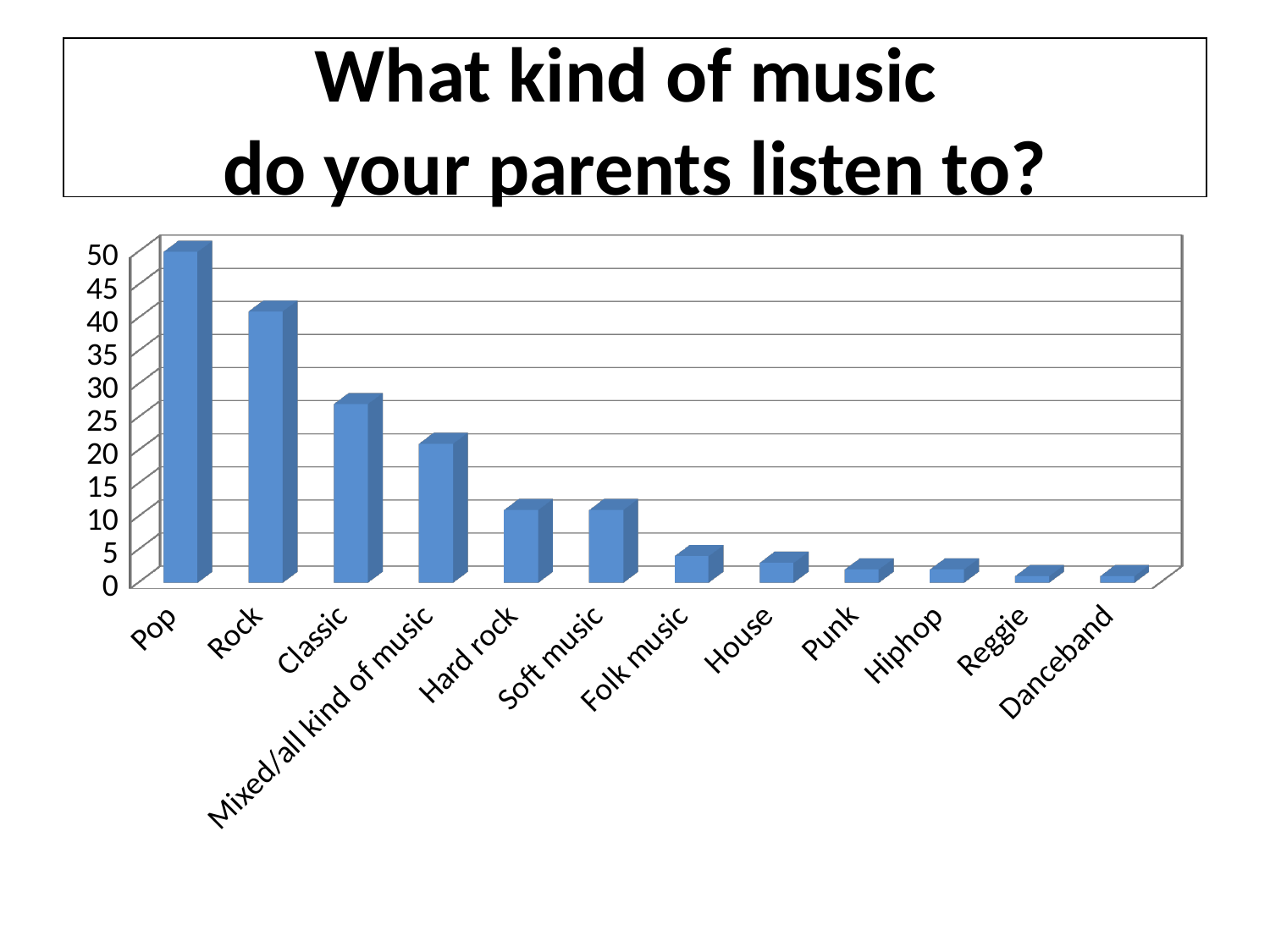
Is the value for Pop greater or less than 45? greater Do the values generally rise or fall moving from left to right along the x axis? fall Which is larger, the value for Mixed/all kind of music or the value for Folk music? Mixed/all kind of music Which is larger, the value for Classic or the value for Hard rock? Classic How many music categories are shown on the x axis? 12 Is the value for Rock greater or less than 35? greater Is the value for Classic greater or less than 20? greater Which music category has the highest value? Pop Which is larger, the value for Pop or the value for Rock? Pop What is the title of the chart? What kind of music do your parents listen to? What kind of chart is shown on the slide? bar chart